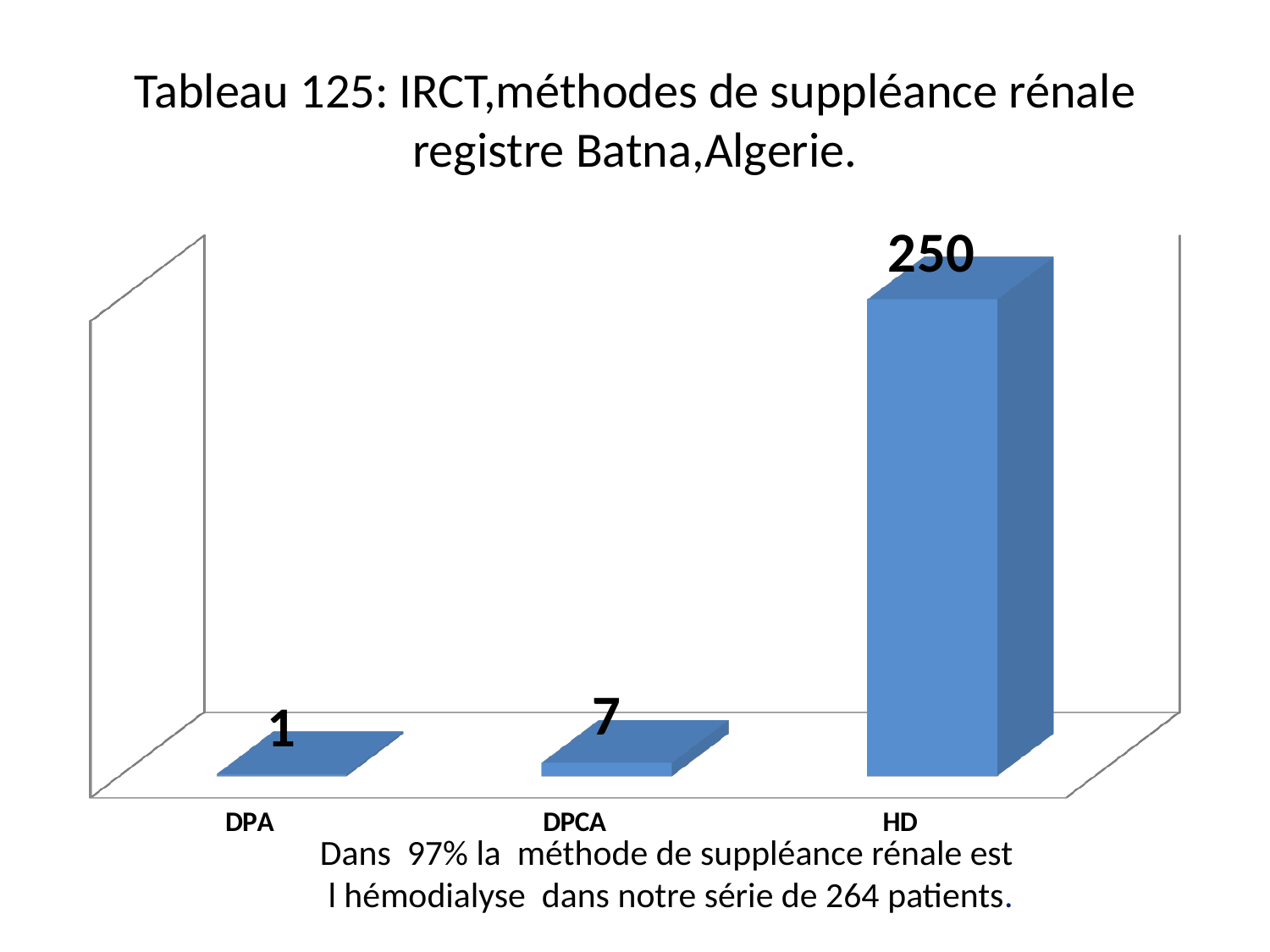
Which category has the highest value? HD What is the difference between the values for HD and DPCA? 243 What is the value for DPCA? 7 What is the value for HD? 250 What kind of chart is shown on the slide? bar chart What is the title of the chart? Tableau 125: IRCT,méthodes de suppléance rénale registre Batna,Algerie. What is the value for DPA? 1 Which category has the lowest value? DPA Do the values rise or fall from DPA to HD along the x axis? rise How many categories are shown on the x axis? 3 Which is larger, the value for DPCA or the value for DPA? DPCA What is the difference between the values for DPCA and DPA? 6